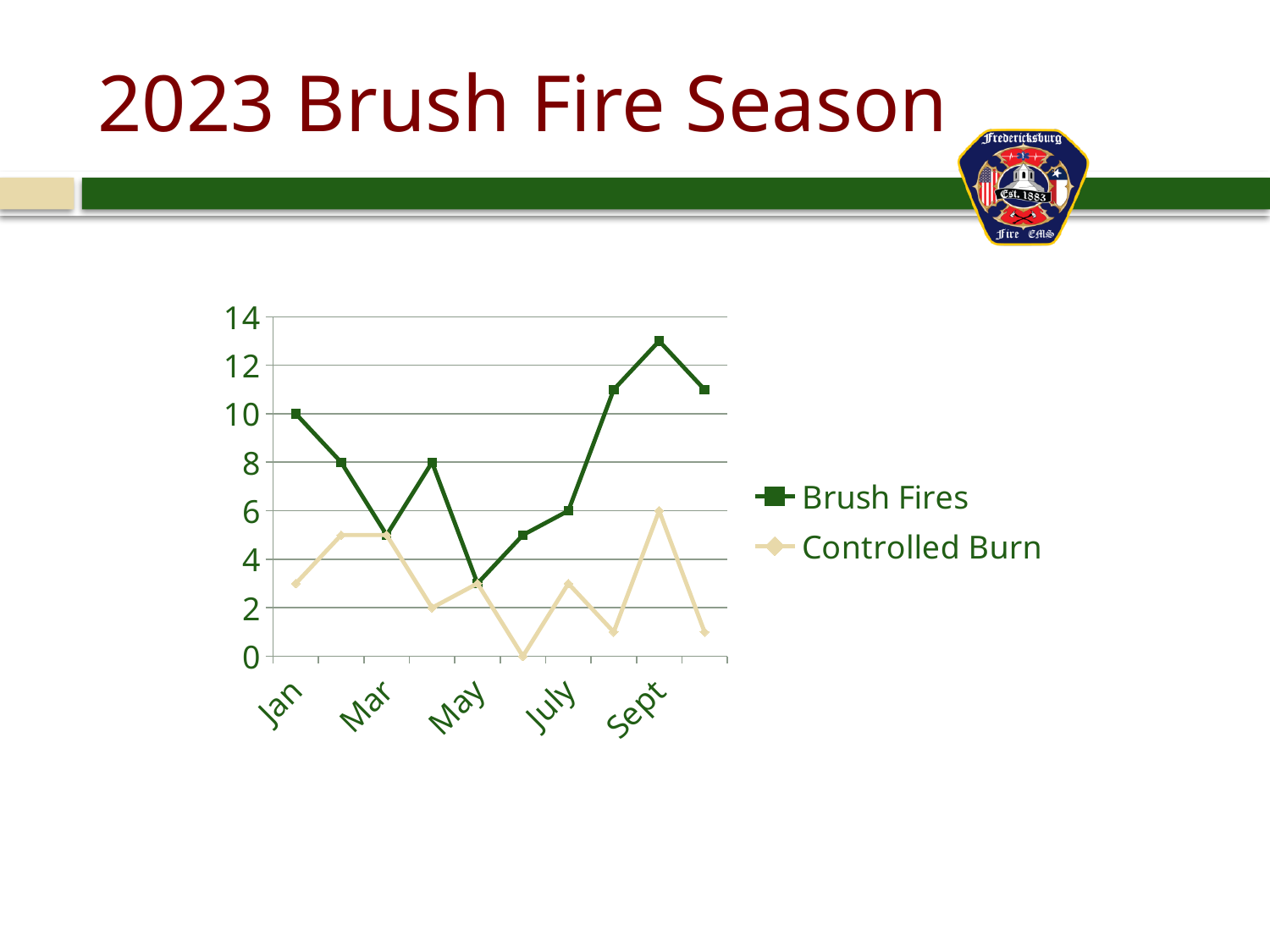
Is the value for Brush Fires in Sept greater or less than 12? greater What are the two series named in the legend? Brush Fires and Controlled Burn In Sept, which series has the larger value, Brush Fires or Controlled Burn? Brush Fires What is the value for Controlled Burn in Sept? 6 How many series does the legend list? 2 Does the Brush Fires series rise or fall from July to Sept? rise What is the value for Brush Fires in July? 6 Is the value for Controlled Burn in Jan greater or less than 4? less What is the value for Brush Fires in Jan? 10 In which labeled month does the Brush Fires series reach its lowest value? May In which labeled month does the Brush Fires series reach its highest value? Sept What kind of chart is shown on the slide? line chart